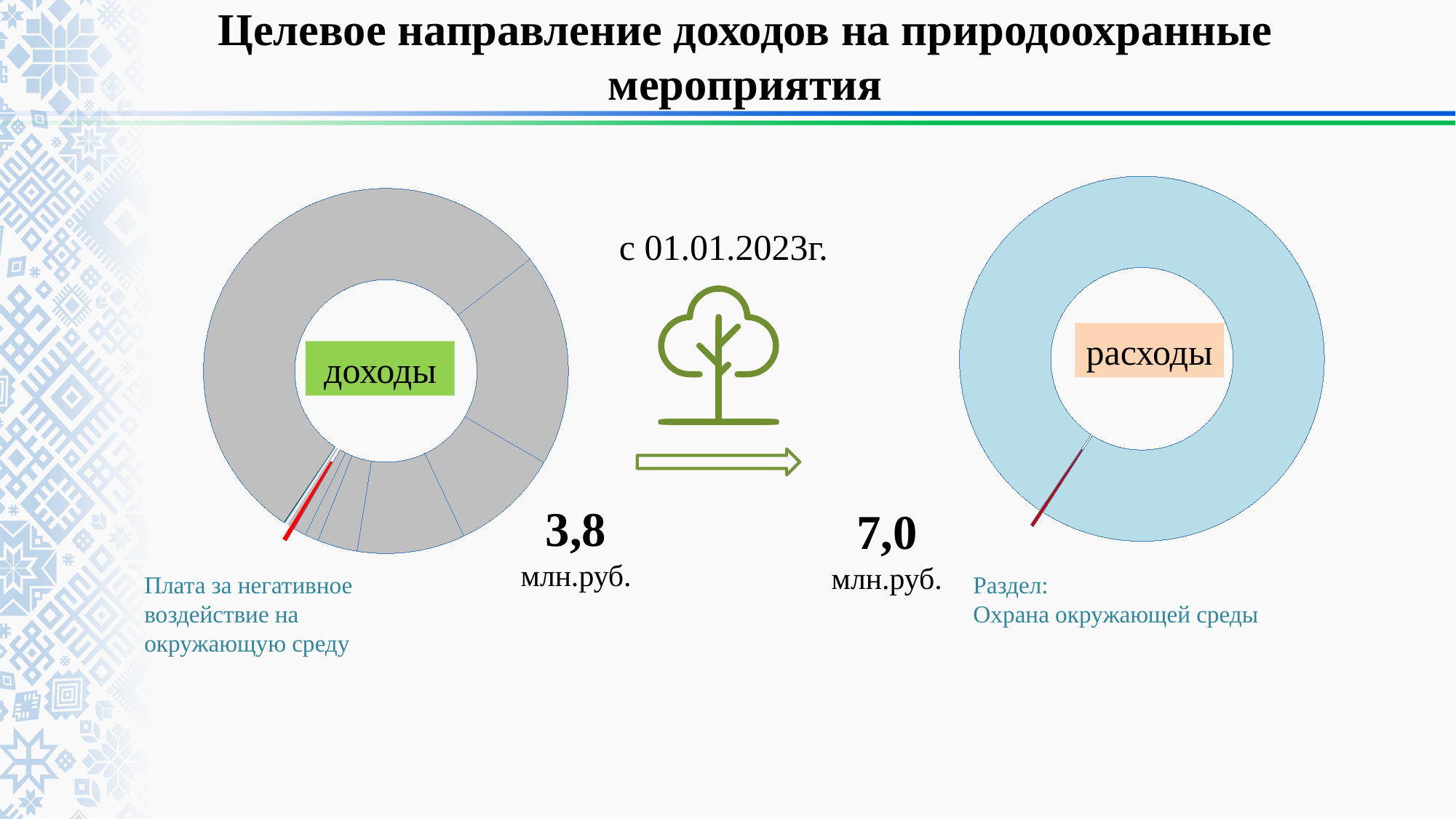
In the "доходы" chart, is the highlighted slice "Плата за негативное воздействие на окружающую среду" a large or a small share of the ring? small As of what date are the values on the slide given? с 01.01.2023г. In the "расходы" chart, what value is printed for the highlighted slice "Раздел: Охрана окружающей среды"? 7,0 млн.руб. What is the difference between the 7,0 млн.руб. highlighted in the "расходы" chart and the 3,8 млн.руб. highlighted in the "доходы" chart? 3,2 млн.руб. What colour are the slices of the "доходы" chart on the left? grey In the "доходы" chart, what value is printed for the highlighted slice "Плата за негативное воздействие на окружающую среду"? 3,8 млн.руб. Which printed value is larger: the 3,8 млн.руб. highlighted in the "доходы" chart or the 7,0 млн.руб. highlighted in the "расходы" chart? 7,0 млн.руб. (расходы) In the "расходы" chart, is the highlighted slice "Охрана окружающей среды" a large or a small share of the ring? small What kind of chart is the "расходы" chart on the right of the slide? doughnut (pie) chart What kind of chart is the "доходы" chart on the left of the slide? doughnut (pie) chart